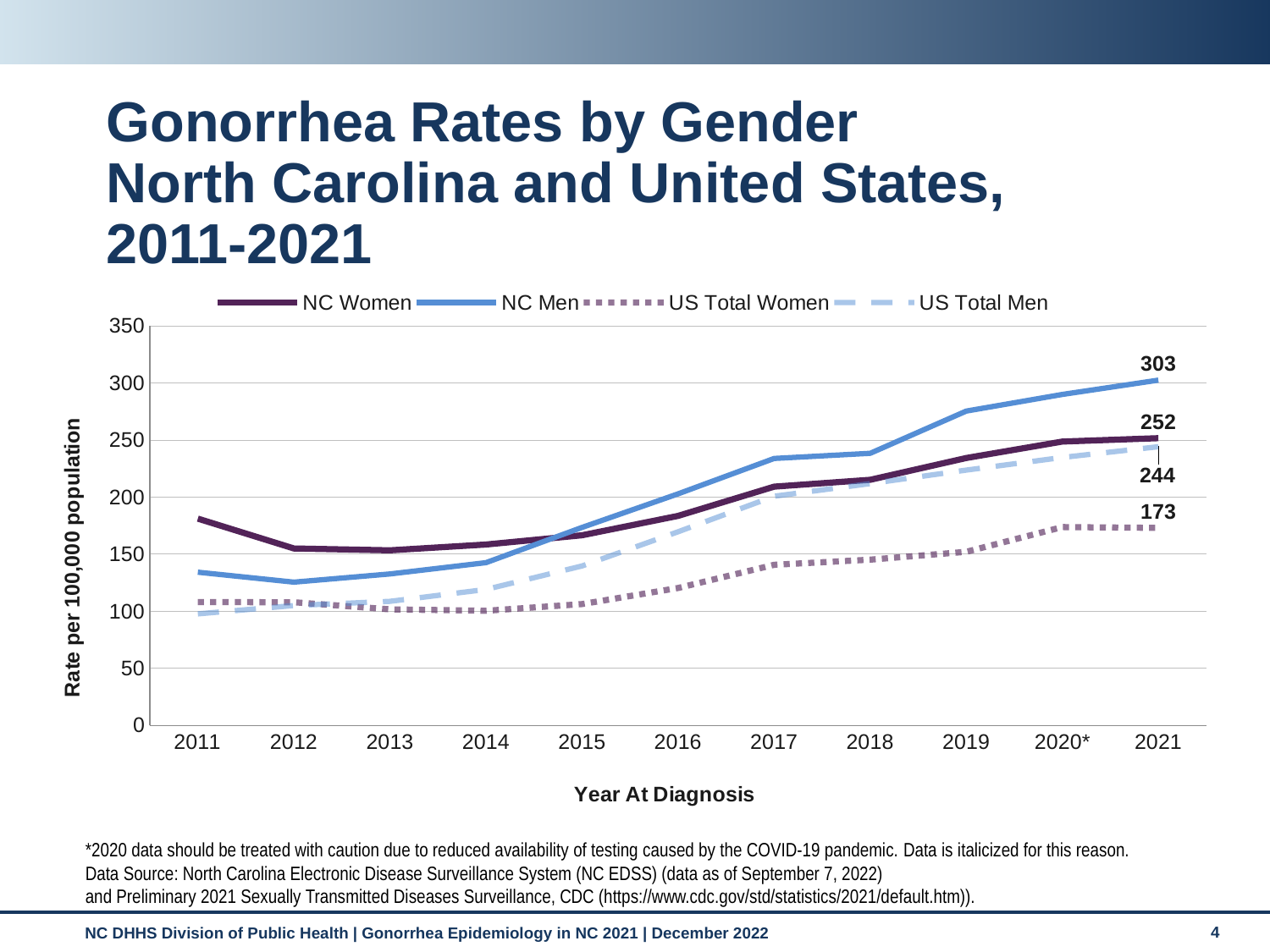
What is the difference between the NC Men and NC Women rates in 2021? 51 What is the US Total Women rate in 2021? 173 What is the NC Men gonorrhea rate in 2021? 303 What is the NC Women gonorrhea rate in 2021? 252 Is the NC Women rate in 2011 greater or less than 150? greater What is the US Total Men rate in 2021? 244 How many years are shown on the x axis? 11 Which series has the lowest rate in 2021? US Total Women Which series has the highest rate in 2021? NC Men What is the label of the y axis? Rate per 100,000 population What type of chart is shown on the slide? Line chart How many series does the legend list? 4